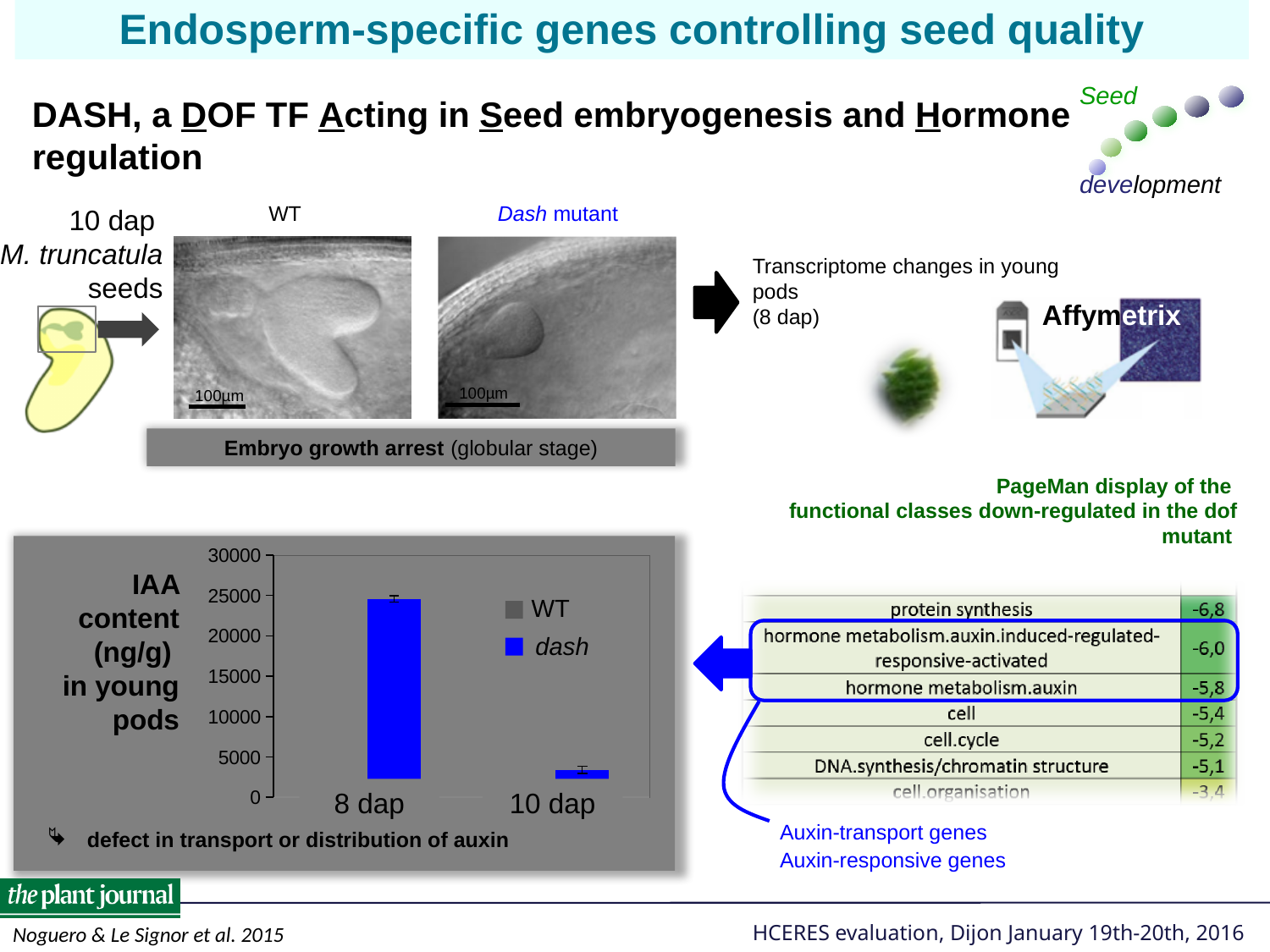
In the IAA content chart, at which category is the dash value lowest? 10 dap How many series does the legend of the IAA content chart list? 2 In the IAA content chart, do the dash values rise or fall from 8 dap to 10 dap? fall What kind of chart is shown in the lower-left panel of the slide? bar chart Which series is shown in blue in the IAA content chart? dash In the IAA content chart, is the dash value at 10 dap greater or less than 5000? less How many categories are shown on the x axis of the IAA content chart? 2 In the IAA content chart, is the dash value at 8 dap greater or less than 20000? greater What is the highest tick value on the y axis of the IAA content chart? 30000 In the IAA content chart, at which category is the dash value highest? 8 dap In the IAA content chart, which category has the higher dash value, 8 dap or 10 dap? 8 dap